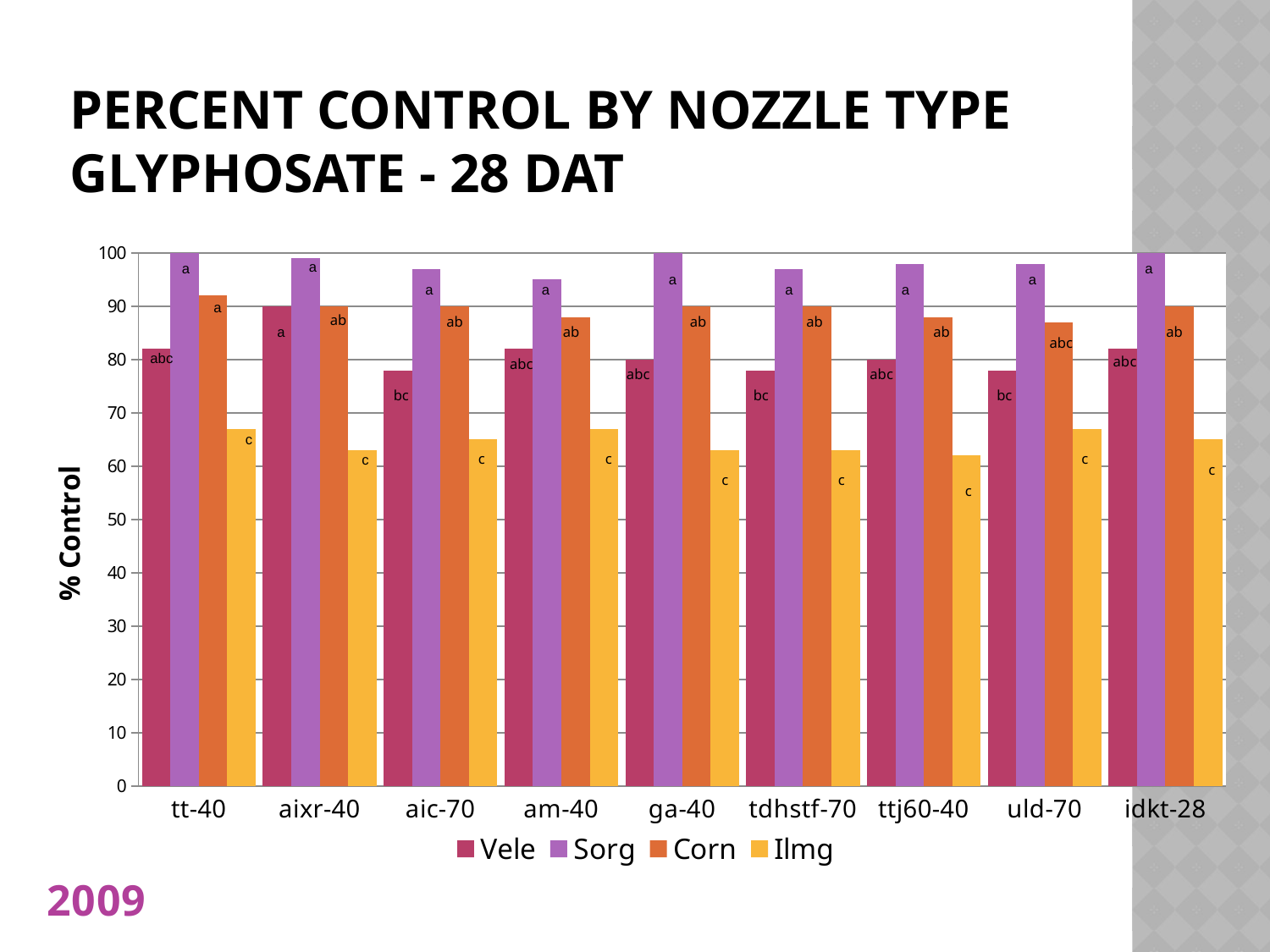
For tt-40, which is larger: the Sorg value or the Ilmg value? Sorg What are the four series named in the legend? Vele, Sorg, Corn, Ilmg Which series has the highest value for tt-40? Sorg Is the Vele value for aic-70 greater or less than 80? less What type of chart is shown on the slide? bar chart What is the title of the y axis? % Control Is the Corn value for uld-70 greater or less than 90? less Is the Sorg value for am-40 greater or less than 90? greater How many nozzle type categories are shown on the x axis? 9 Which series has the lowest value for ga-40? Ilmg How many series does the legend list? 4